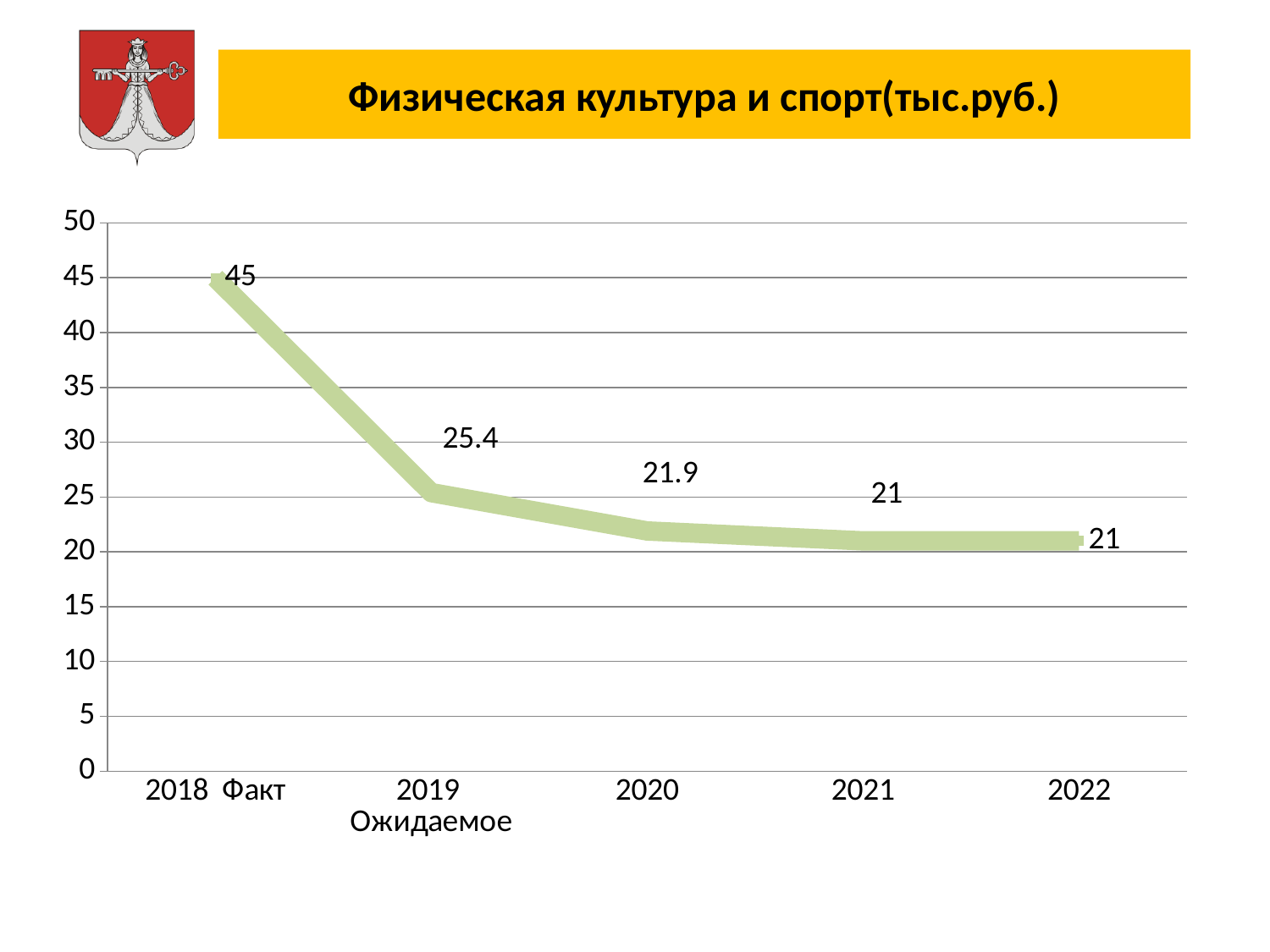
Which year has the highest value? 2018 Факт Do the values rise or fall from 2018 to 2022? fall Which is larger, the value for 2019 Ожидаемое or the value for 2020? 2019 Ожидаемое Is the value for 2018 Факт greater or less than 40? greater How many data points are plotted on the chart? 5 What is the value for 2022? 21 What is the value for 2018 Факт? 45 What kind of chart is shown on the slide? line chart What is the value for 2020? 21.9 What is the difference between the values for 2018 Факт and 2019 Ожидаемое? 19.6 What is the difference between the values for 2020 and 2021? 0.9 What is the value for 2019 Ожидаемое? 25.4